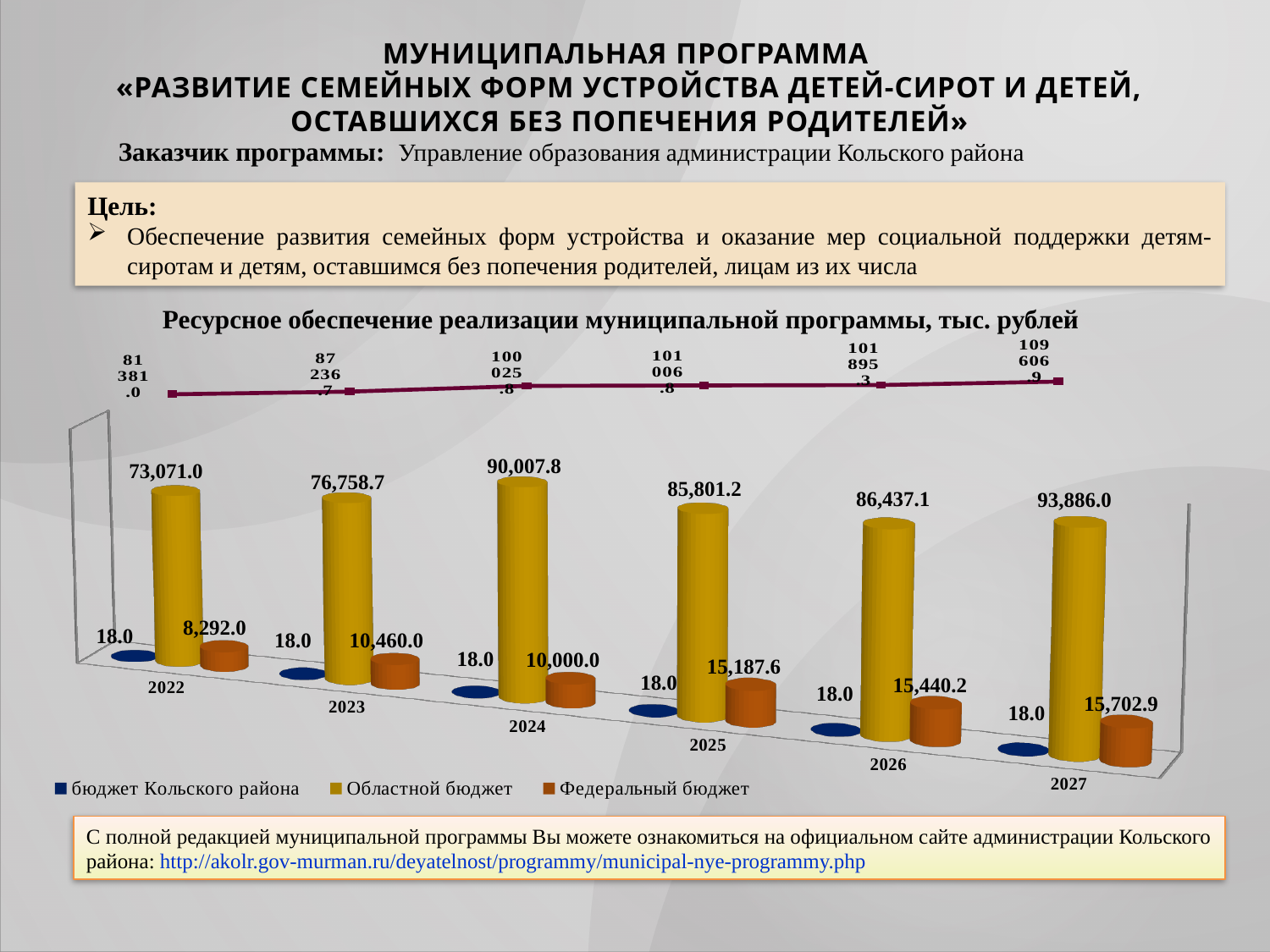
What kind of chart is used to show the budget values? bar chart In which year is Федеральный бюджет the lowest? 2022 What is the value of Федеральный бюджет for 2027? 15,702.9 What is the difference between Областной бюджет in 2027 and in 2022? 20,815.0 In which year is Областной бюджет the highest? 2027 Does Федеральный бюджет rise or fall from 2024 to 2027? rise Which year has the larger Федеральный бюджет, 2023 or 2024? 2023 What is the difference between Федеральный бюджет in 2026 and in 2025? 252.6 What is the value of бюджет Кольского района for 2022? 18.0 How many series does the legend list? 3 How many years are shown on the x axis of the chart? 6 What is the value of Областной бюджет for 2024? 90,007.8